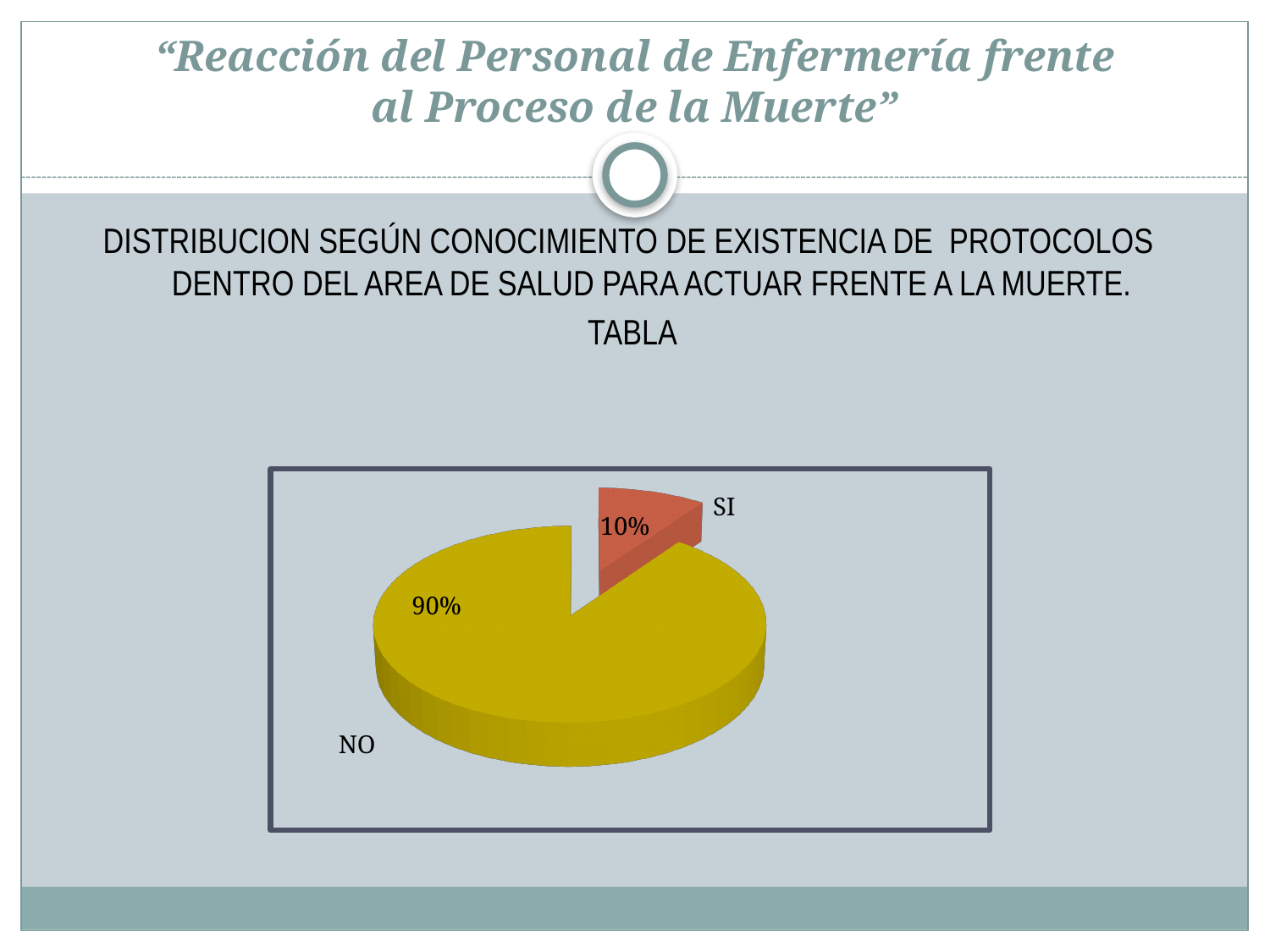
Which slice is larger, "SI" or "NO"? NO What is the difference in percentage points between the "NO" and "SI" slices? 80 What colour is the "SI" slice of the pie chart? Red Which category has the smallest share of the pie chart? SI What percentage of the pie chart corresponds to the "NO" slice? 90% What kind of chart is shown on the slide? Pie chart Which category has the largest share of the pie chart? NO What share of the pie does the "SI" slice represent? 10% What percentage of the pie chart corresponds to the "SI" slice? 10% What colour is the "NO" slice of the pie chart? Yellow How many slices does the pie chart have? 2